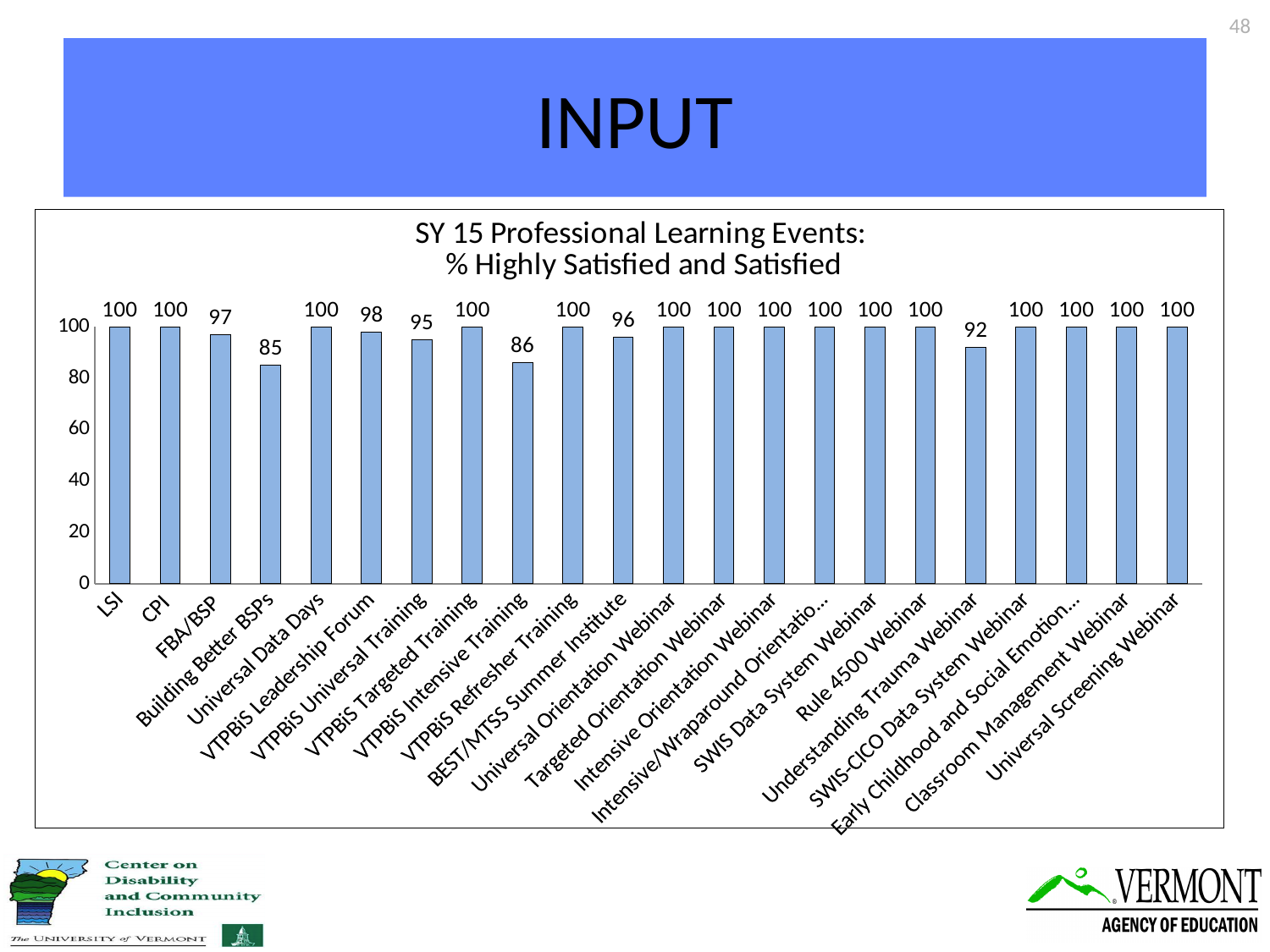
What is the difference between the values for LSI and Building Better BSPs? 15 What is the value for Understanding Trauma Webinar? 92 Which category has the lowest value? Building Better BSPs What is the value for VTPBiS Intensive Training? 86 What is the title of the chart? SY 15 Professional Learning Events: % Highly Satisfied and Satisfied What kind of chart is this? Bar chart What is the value for Building Better BSPs? 85 How many categories are shown on the x axis? 22 What is the value for FBA/BSP? 97 Which is larger, the value for VTPBiS Intensive Training or the value for Understanding Trauma Webinar? Understanding Trauma Webinar What is the difference between the values for VTPBiS Leadership Forum and VTPBiS Universal Training? 3 What is the value for BEST/MTSS Summer Institute? 96